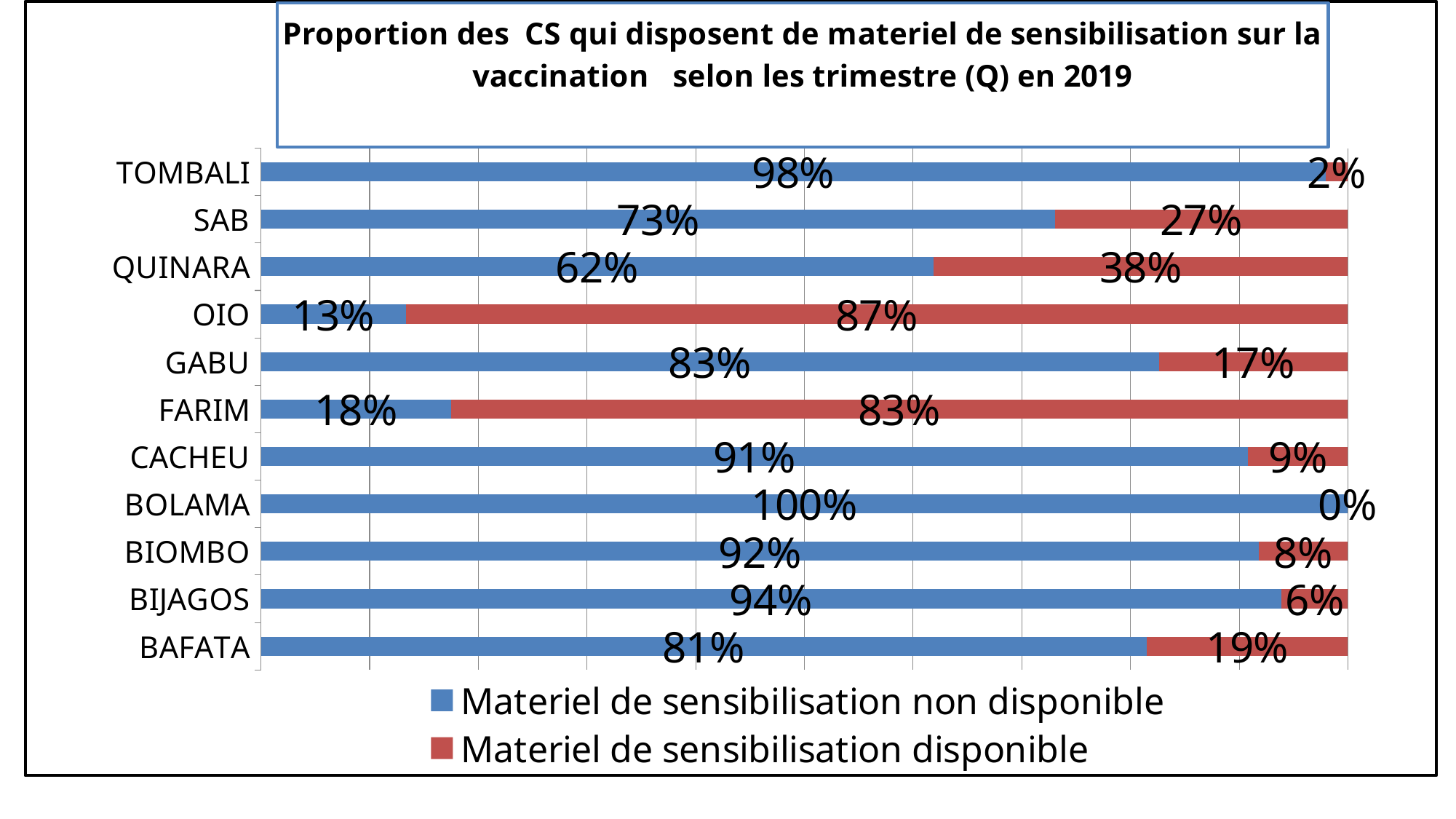
What kind of chart is shown on the slide? Stacked bar chart Which colour represents 'Materiel de sensibilisation disponible'? Red What is the value of 'Materiel de sensibilisation non disponible' for SAB? 73% Which region has the lowest value for 'Materiel de sensibilisation non disponible'? OIO Which is larger: the 'Materiel de sensibilisation disponible' value for GABU or for BAFATA? BAFATA How many regions are shown on the chart? 11 What is the value of 'Materiel de sensibilisation disponible' for BAFATA? 19% Which region has the highest value for 'Materiel de sensibilisation disponible'? OIO How many series does the legend list? 2 What is the value of 'Materiel de sensibilisation disponible' for OIO? 87% Which region has the lowest value for 'Materiel de sensibilisation disponible'? BOLAMA What is the difference between the 'Materiel de sensibilisation disponible' values for QUINARA and SAB? 11%